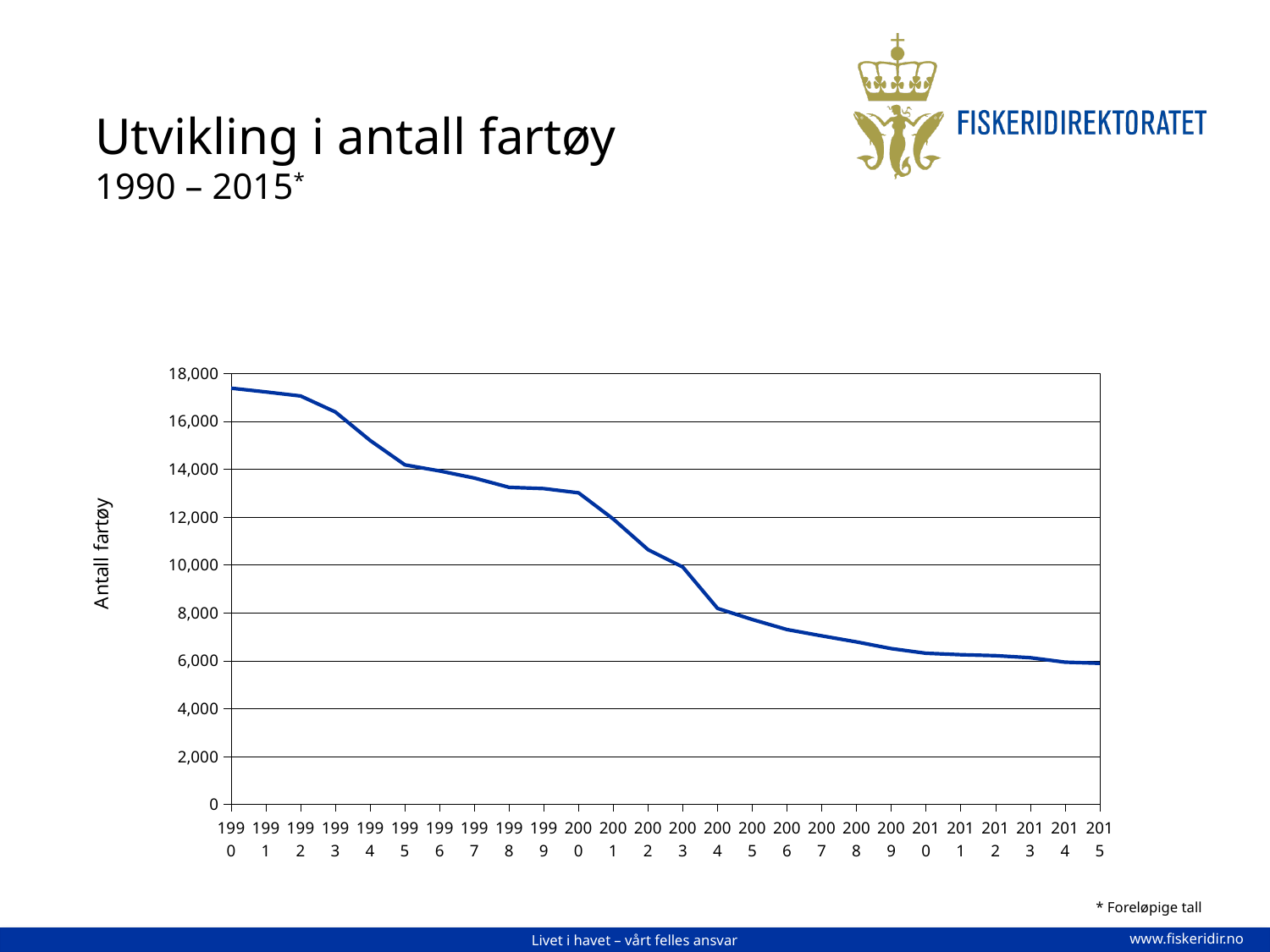
What is the label on the y axis of the chart? Antall fartøy Is the value for 1990 greater or less than 16,000? greater Is the value for 2000 greater or less than 12,000? greater Do the values rise or fall from 1990 to 2015? fall How many years are plotted along the x axis of the chart? 26 Which year has the lowest number of vessels (Antall fartøy)? 2015 What is the title of the slide containing the chart? Utvikling i antall fartøy 1990 – 2015* Is the value for 2004 greater or less than 10,000? less Which is larger, the value for 1995 or the value for 2005? 1995 What kind of chart is shown on the slide? line chart Which year has the highest number of vessels (Antall fartøy)? 1990